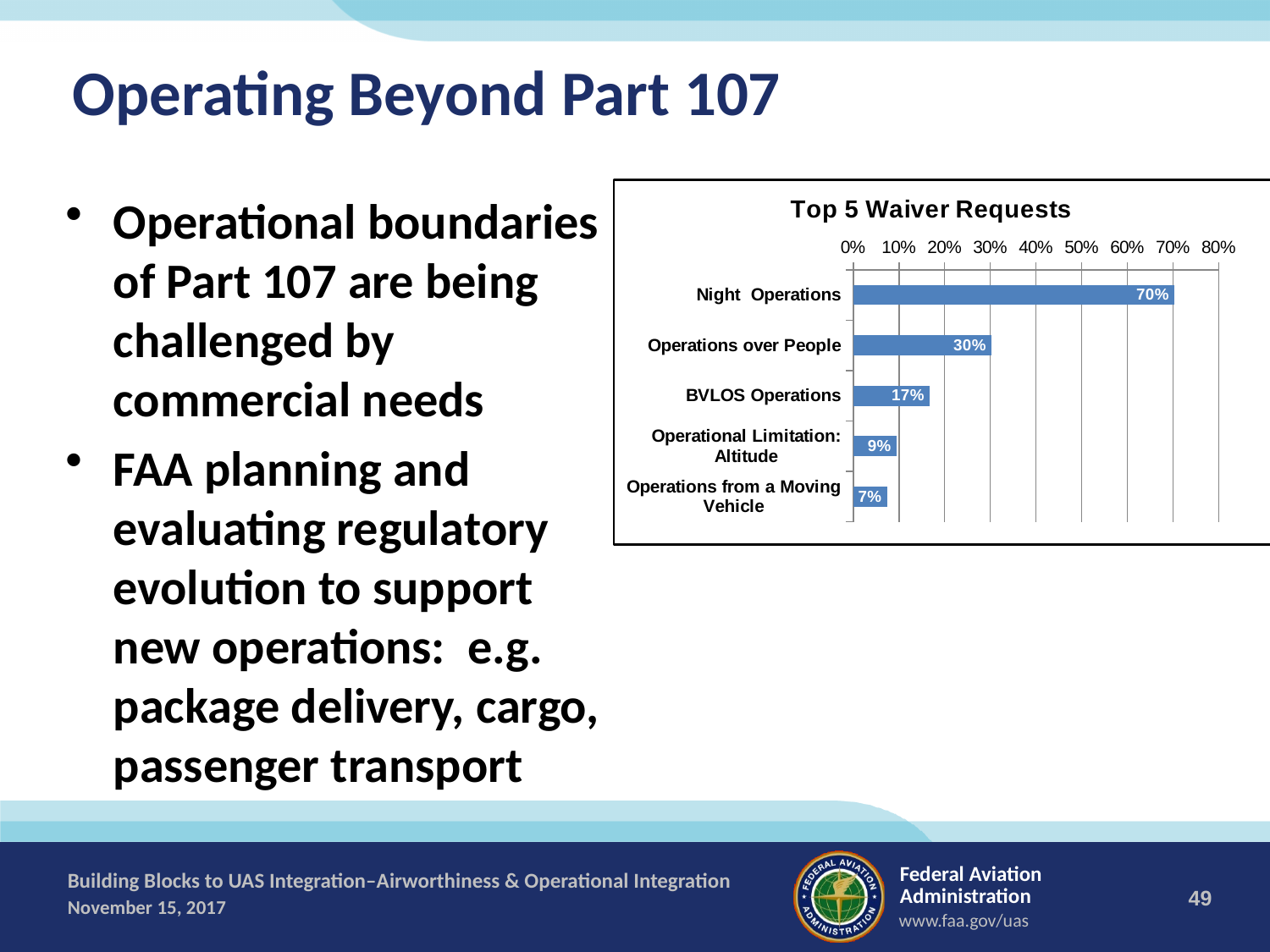
How many categories are shown in the chart? 5 What is the difference between the values for BVLOS Operations and Operational Limitation: Altitude? 8% What is the value for Operations from a Moving Vehicle? 7% Which category has the lowest value? Operations from a Moving Vehicle Which is larger, the value for Operations over People or the value for BVLOS Operations? Operations over People What is the value for Night Operations? 70% What is the value for Operations over People? 30% What is the value for BVLOS Operations? 17% Which category has the highest value? Night Operations What is the difference between the values for Night Operations and Operations over People? 40% What is the title of the chart? Top 5 Waiver Requests What kind of chart is shown on the slide? Bar chart